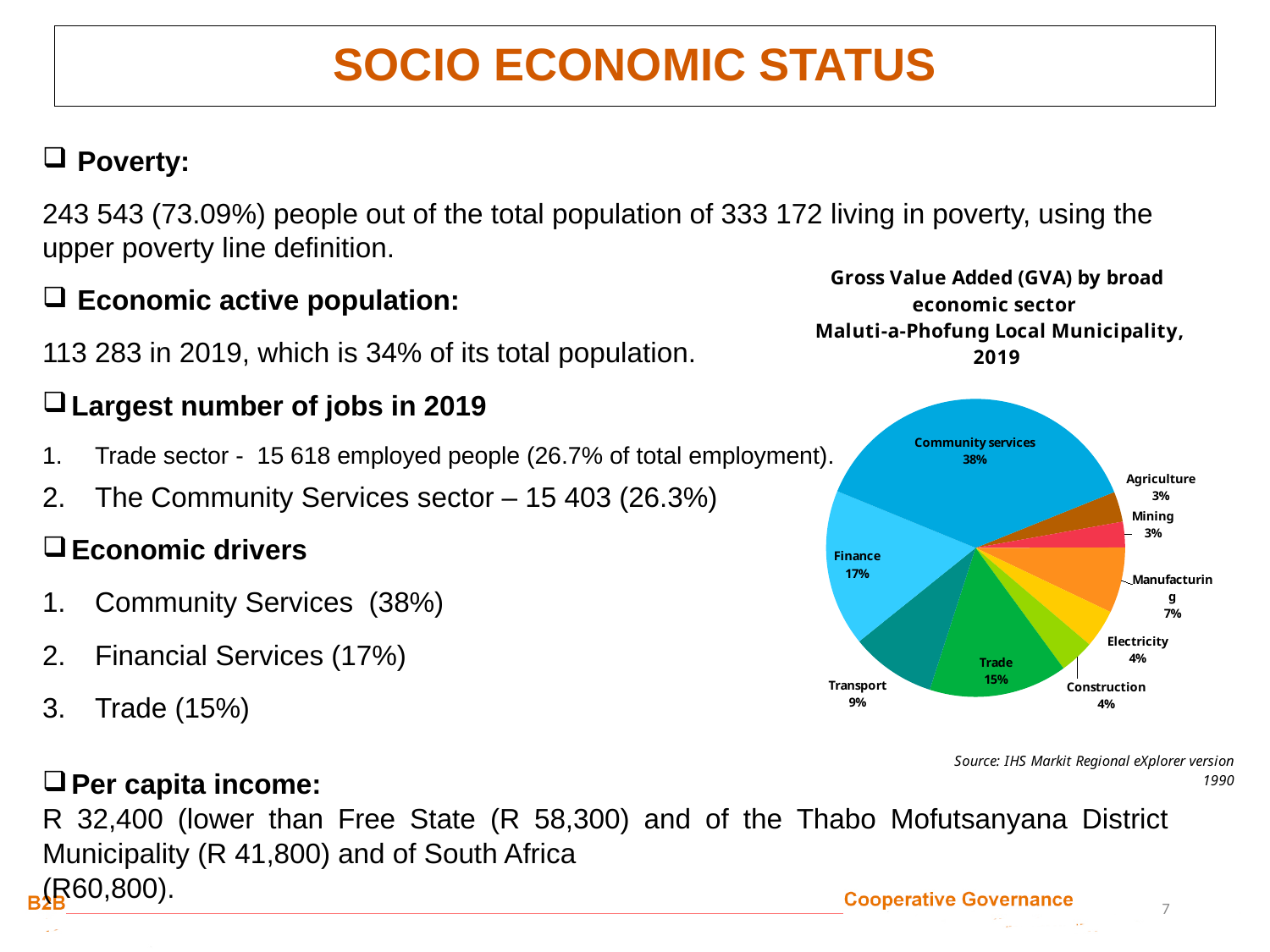
Which has a larger share of GVA, Trade or Transport? Trade What year does the pie chart title refer to? 2019 What type of chart is shown on the slide? Pie chart What share of GVA does Community services account for in the pie chart? 38% What is the value for Transport in the pie chart? 9% What is the value shown for Finance in the pie chart? 17% Which sector has the largest share of GVA in the pie chart? Community services What is the difference in percentage points between Community services and Finance? 21 What percentage does the Trade slice show? 15% What is the difference in percentage points between Manufacturing and Electricity? 3 What percentage is shown for Manufacturing? 7% How many sectors (slices) are shown in the pie chart? 9